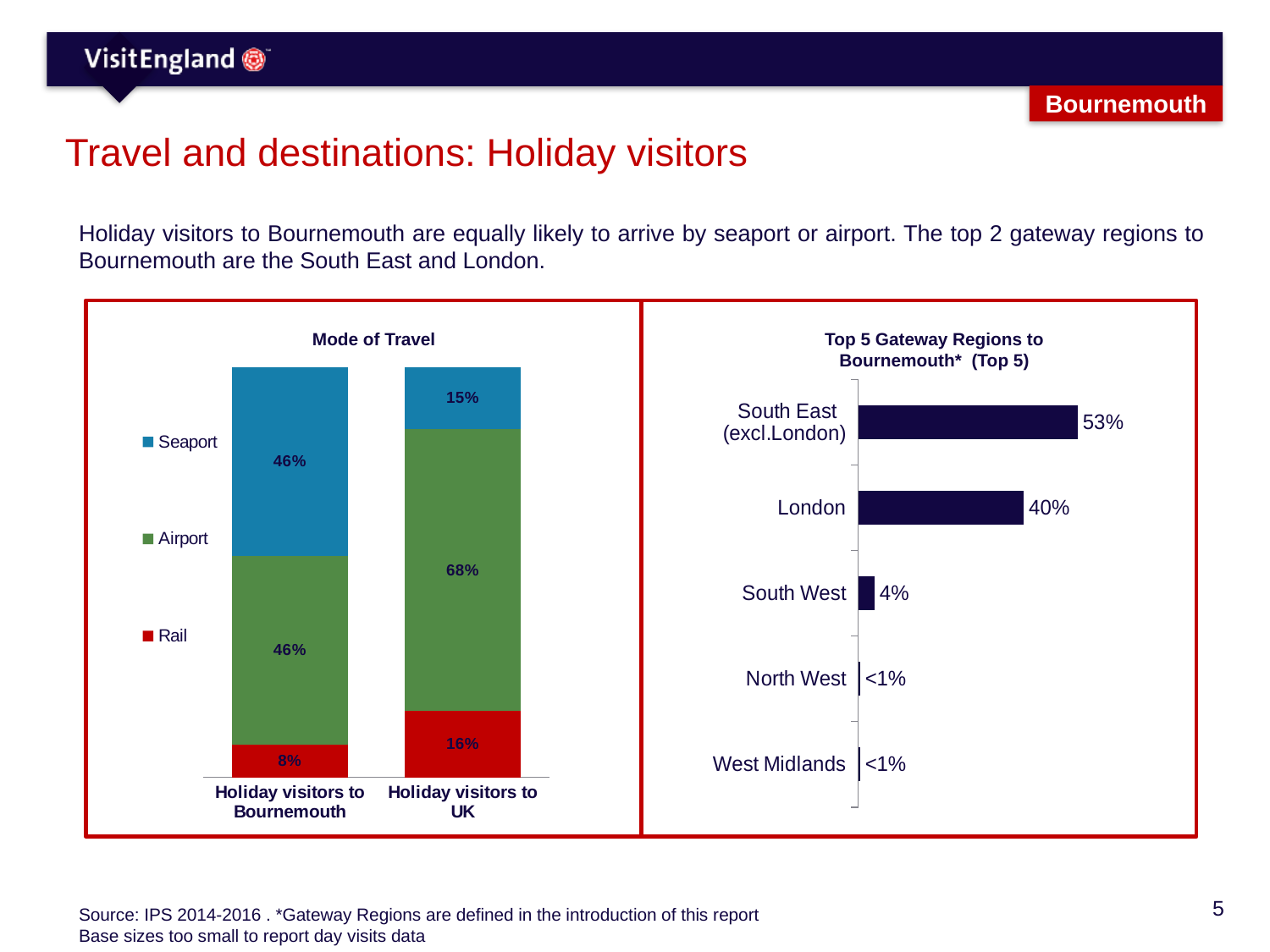
In the Mode of Travel chart, what percentage of holiday visitors to Bournemouth arrive by seaport? 46% In the Top 5 Gateway Regions to Bournemouth chart, what is the value for London? 40% How many series does the legend of the Mode of Travel chart list? 3 What type of chart is the Mode of Travel chart? Stacked bar chart In the Mode of Travel chart, which is larger: the seaport share for holiday visitors to Bournemouth or for holiday visitors to the UK? Holiday visitors to Bournemouth In the Top 5 Gateway Regions to Bournemouth chart, which region has the highest value? South East (excl.London) In the Mode of Travel chart, what percentage of holiday visitors to Bournemouth arrive by rail? 8% In the Top 5 Gateway Regions to Bournemouth chart, what is the value for North West? <1% In the Mode of Travel chart, what percentage of holiday visitors to the UK arrive by airport? 68% In the Top 5 Gateway Regions to Bournemouth chart, what is the difference between the South East (excl.London) and London values? 13% How many regions are shown in the Top 5 Gateway Regions to Bournemouth chart? 5 In the Mode of Travel chart, what is the difference between the rail share for holiday visitors to the UK and for holiday visitors to Bournemouth? 8%